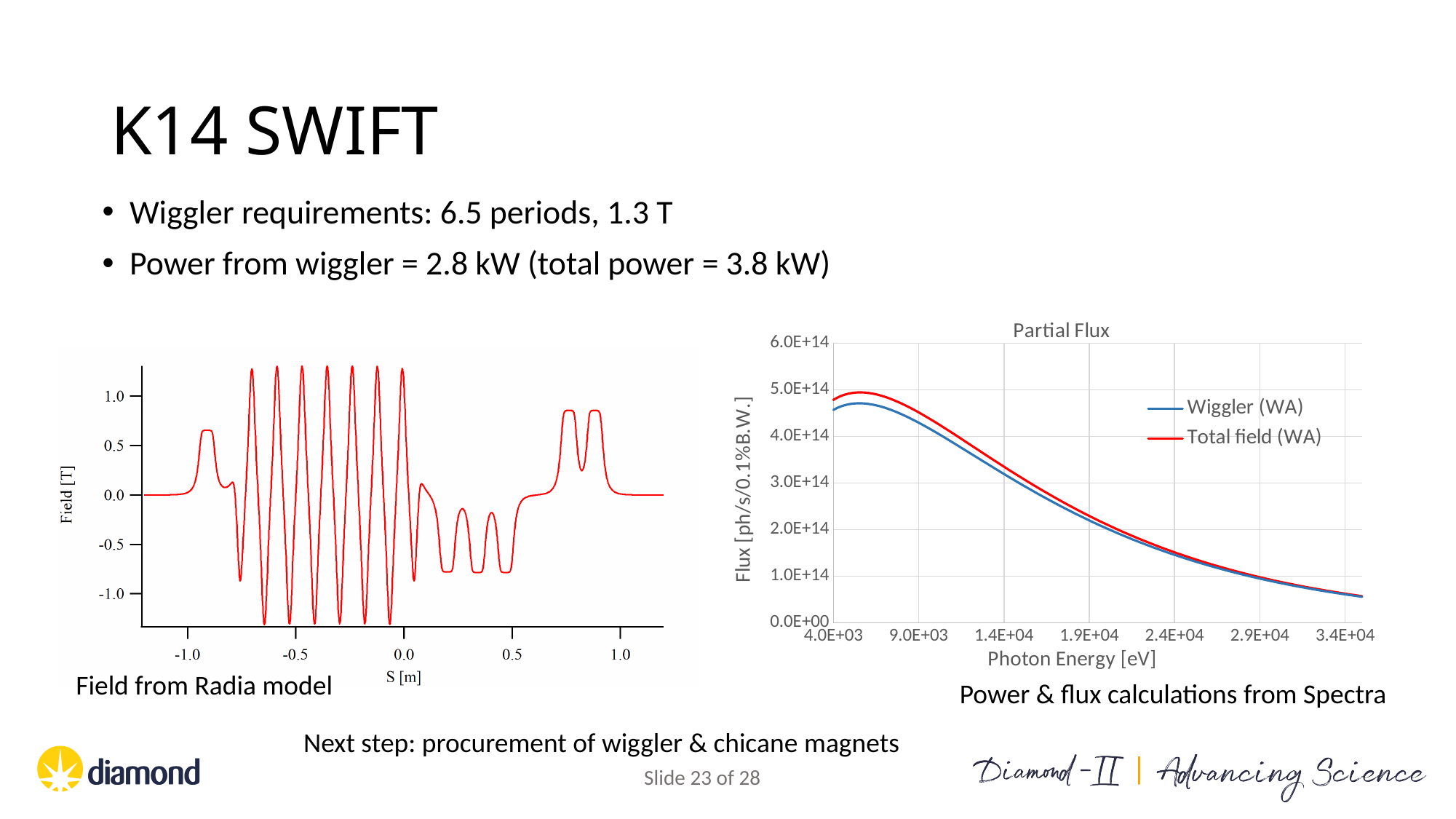
How many series does the legend of the 'Partial Flux' chart list? 2 What kind of chart is the 'Partial Flux' chart on the right of the slide? line chart In the 'Partial Flux' chart, is the Total field (WA) flux at 1.4E+04 eV greater or less than 3.0E+14? greater In the 'Field from Radia model' chart, is the maximum field in the central wiggler section greater or less than 1.0 T? greater In the 'Partial Flux' chart, is the Total field (WA) flux at 3.4E+04 eV greater or less than 1.0E+14? less What kind of chart is the 'Field from Radia model' chart on the left of the slide? line chart In the 'Partial Flux' chart, do the flux values overall rise or fall as photon energy increases from 9.0E+03 to 3.4E+04 eV? fall In the 'Partial Flux' chart, which series is drawn in red? Total field (WA) What is the x-axis label of the 'Partial Flux' chart? Photon Energy [eV] In the 'Partial Flux' chart, which series has the higher flux at a photon energy of 9.0E+03 eV, Wiggler (WA) or Total field (WA)? Total field (WA)